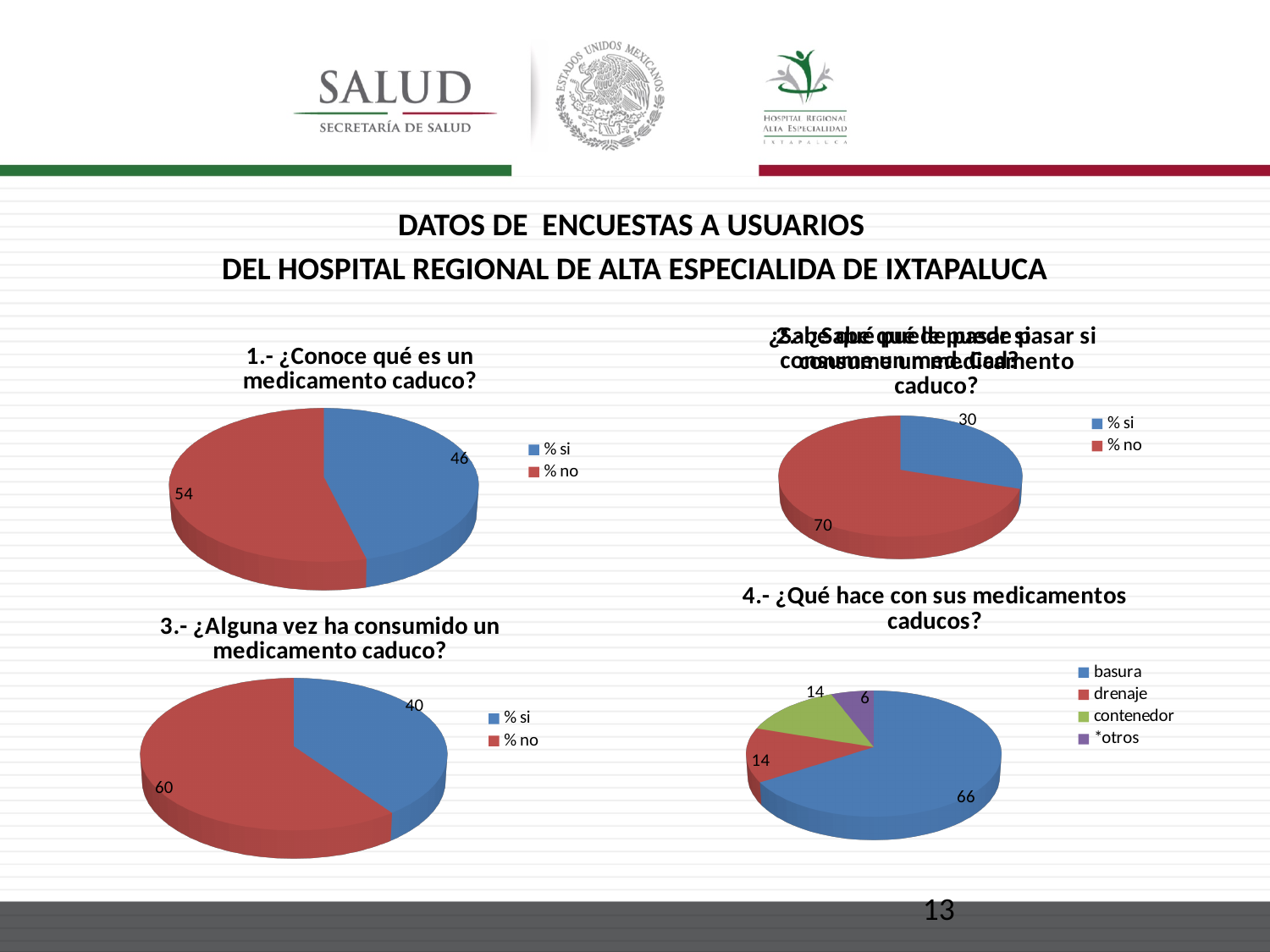
In the chart titled "4.- ¿Qué hace con sus medicamentos caducos?", how many categories does the legend list? 4 In the chart titled "4.- ¿Qué hace con sus medicamentos caducos?", what colour represents "contenedor"? Green What type of chart is used for "4.- ¿Qué hace con sus medicamentos caducos?"? Pie chart In the chart titled "3.- ¿Alguna vez ha consumido un medicamento caduco?", which category has the largest value? % no In the chart titled "4.- ¿Qué hace con sus medicamentos caducos?", what is the value for "basura"? 66 In the chart titled "4.- ¿Qué hace con sus medicamentos caducos?", which category has the smallest value? *otros In the chart titled "1.- ¿Conoce qué es un medicamento caduco?", which category has the larger value, "% si" or "% no"? % no In the top-right pie chart, what is the value for "% no"? 70 In the chart titled "3.- ¿Alguna vez ha consumido un medicamento caduco?", what is the value for "% si"? 40 In the chart titled "1.- ¿Conoce qué es un medicamento caduco?", what is the value for "% no"? 54 In the top-right pie chart, what is the difference between the "% no" and "% si" values? 40 In the chart titled "1.- ¿Conoce qué es un medicamento caduco?", what is the value for "% si"? 46